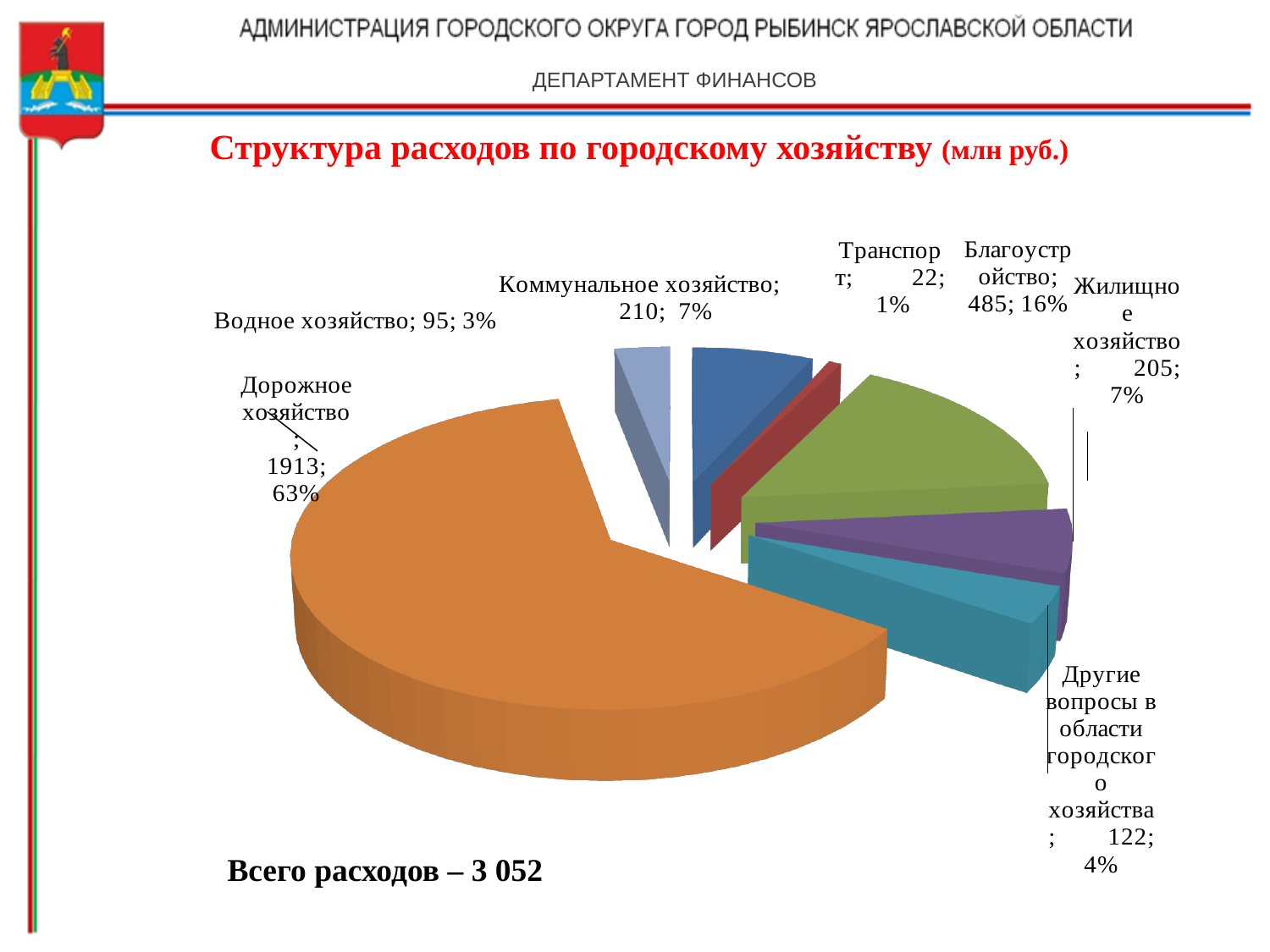
What share of the pie does Дорожное хозяйство represent? 63% What kind of chart is shown on the slide? pie chart Which is larger, the value for Водное хозяйство or the value for Другие вопросы в области городского хозяйства? Другие вопросы в области городского хозяйства How many categories (slices) does the pie chart show? 7 What is the difference between the values for Коммунальное хозяйство and Жилищное хозяйство? 5 Which category has the largest value? Дорожное хозяйство What share of the pie does Благоустройство represent? 16% Which category has the smallest value? Транспорт What is the title of the chart? Структура расходов по городскому хозяйству (млн руб.) What is the value for Дорожное хозяйство? 1913 What is the value for Транспорт? 22 What is the value for Благоустройство? 485